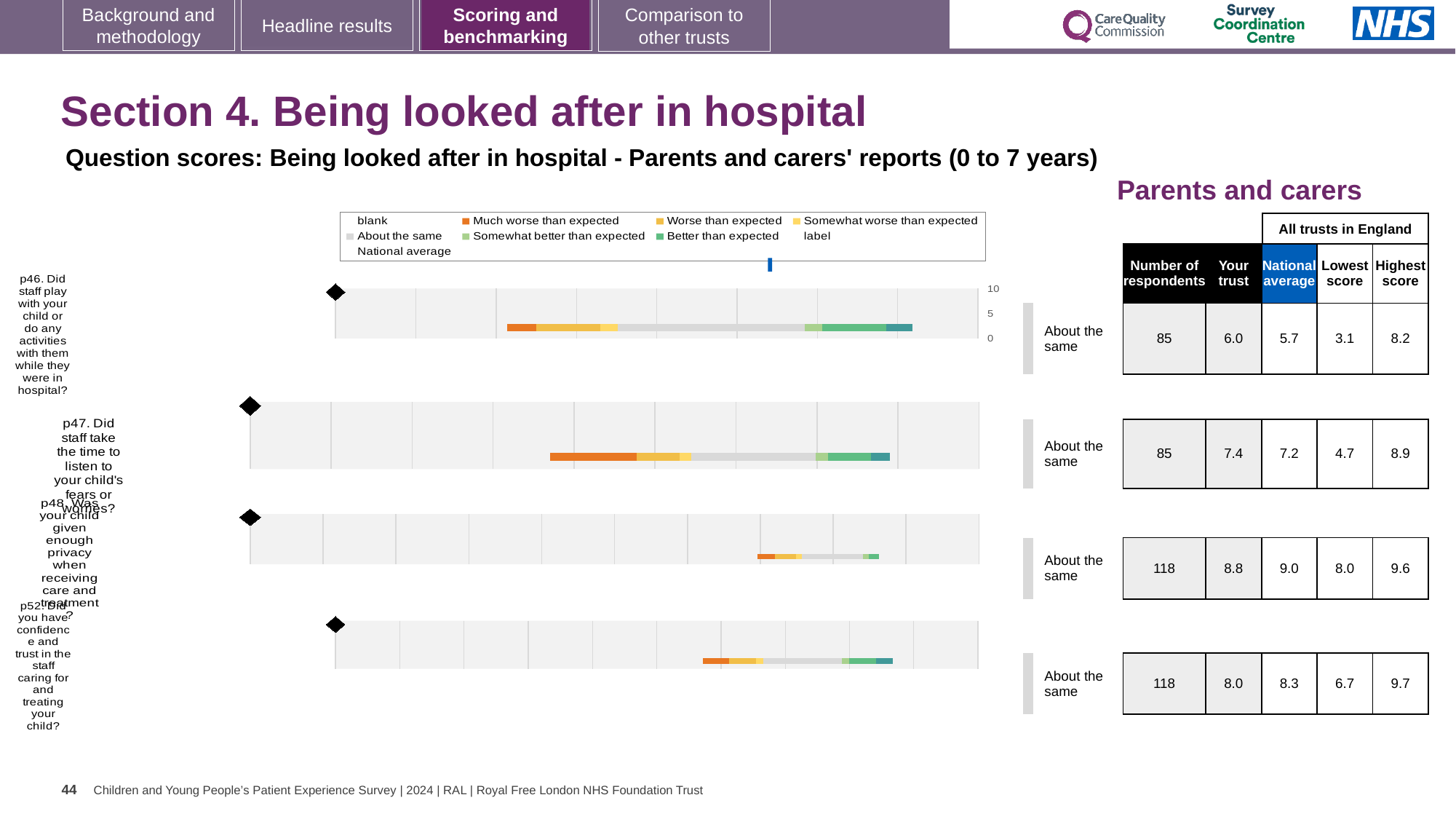
What is the benchmark category shown next to each of the four charts? About the same How many questions (charts) are plotted on the slide? 4 What kind of chart is used to show the question scores on this slide? bar chart What is the national average for p47 (Did staff take the time to listen to your child's fears or worries?)? 7.2 What is the difference between the 'Your trust' score and the national average for p46? 0.3 What is the highest score across all trusts in England for p48 (Was your child given enough privacy when receiving care and treatment?)? 9.6 What is the lowest score across all trusts in England for p52 (Did you have confidence and trust in the staff caring for and treating your child?)? 6.7 Is the 'Your trust' score for p47 larger or smaller than the national average for p47? larger Which question has the highest 'Your trust' score? p48. Was your child given enough privacy when receiving care and treatment? What is the 'Your trust' score for p46 (Did staff play with your child or do any activities with them while they were in hospital?)? 6.0 Which question has the lowest 'Your trust' score? p46. Did staff play with your child or do any activities with them while they were in hospital? How many entries does the chart legend list? 9